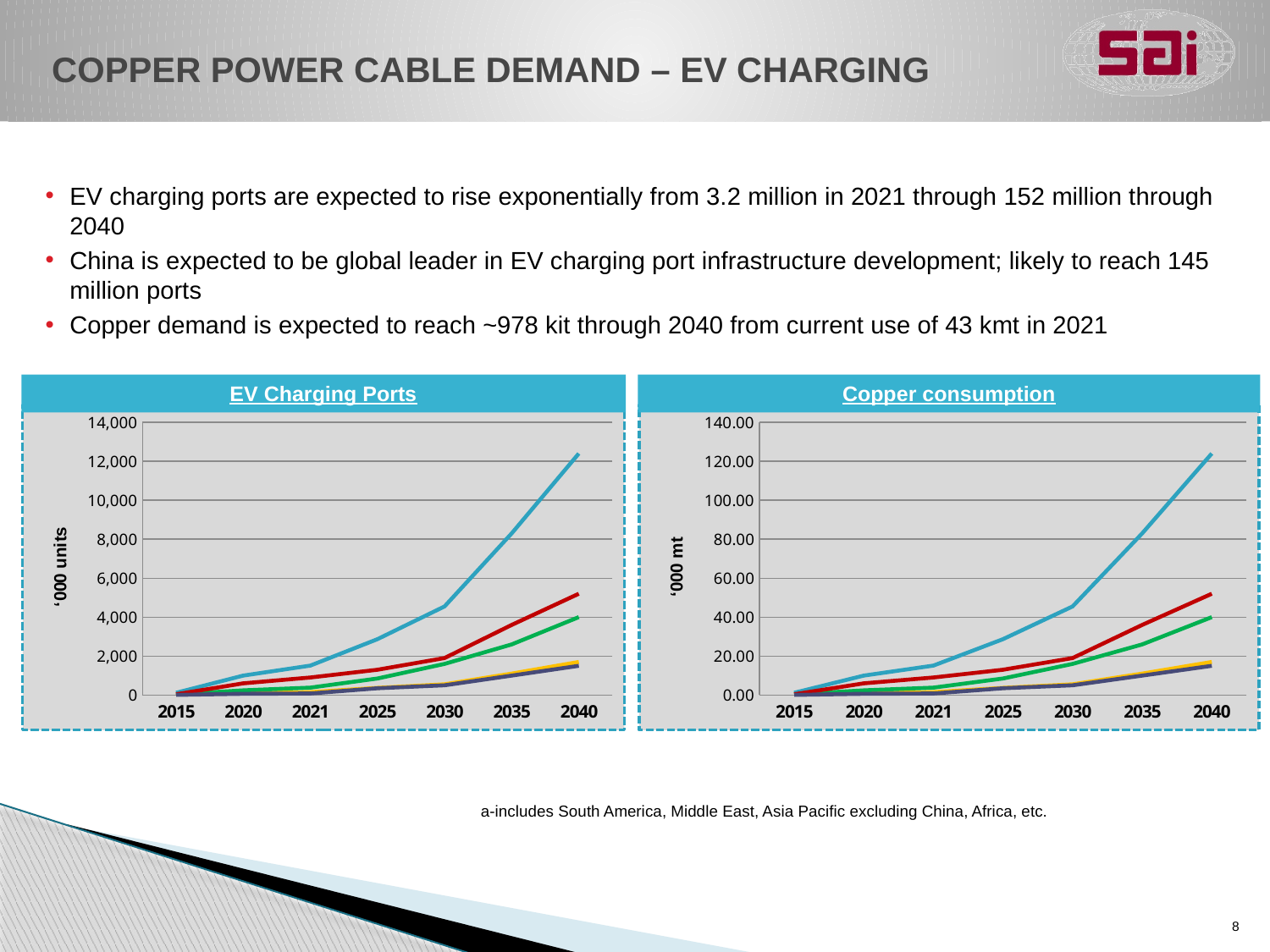
What kind of chart is the EV Charging Ports chart? Line chart In the EV Charging Ports chart, is the value of the blue line in 2040 greater or less than 10,000? greater In the EV Charging Ports chart, is the value of the blue line in 2030 greater or less than 6,000? less In the Copper consumption chart, in which year does the blue line reach its highest value? 2040 In the Copper consumption chart, what is the label on the y axis? '000 mt What kind of chart is the Copper consumption chart? Line chart In the Copper consumption chart, is the value of the blue line in 2040 greater or less than 100.00? greater In the EV Charging Ports chart, does the blue line rise or fall from 2015 to 2040? Rise In the EV Charging Ports chart, what is the label on the y axis? '000 units In the Copper consumption chart, which line is higher in 2040, the blue line or the red line? The blue line How many years are shown on the x axis of the EV Charging Ports chart? 7 How many charts are shown on the slide? 2